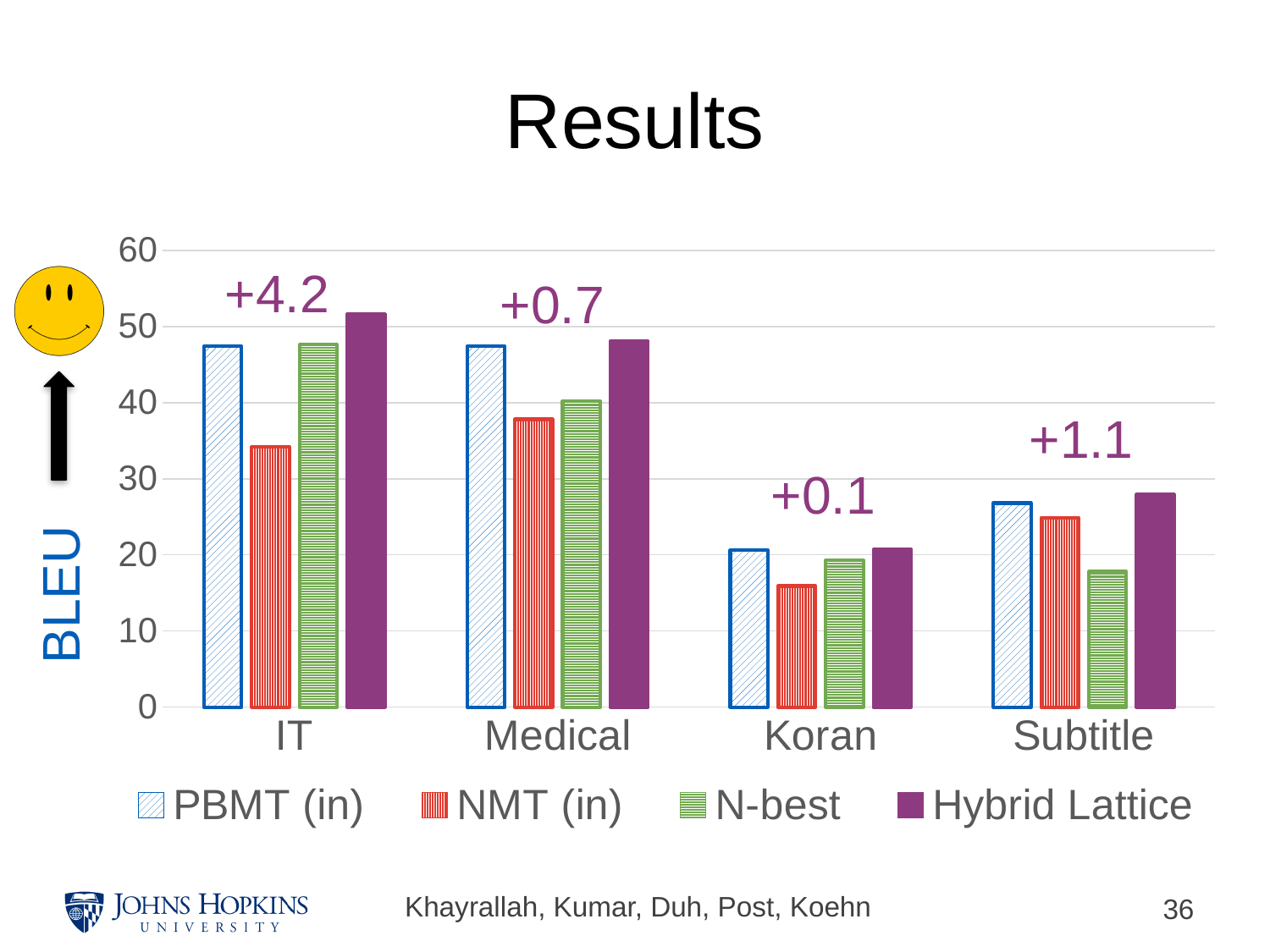
Is the Hybrid Lattice value for IT greater or less than 50? greater What kind of chart is shown on the slide? bar chart What improvement is annotated above the Subtitle group? +1.1 How many series does the legend list? 4 Which category has the highest Hybrid Lattice bar? IT Is the NMT (in) value for Koran greater or less than 20? less Which category has the lowest NMT (in) bar? Koran How many categories are shown on the x axis? 4 What is the label on the y axis? BLEU What improvement is annotated above the Koran group? +0.1 For Subtitle, which is larger: NMT (in) or N-best? NMT (in) What improvement is annotated above the IT group? +4.2